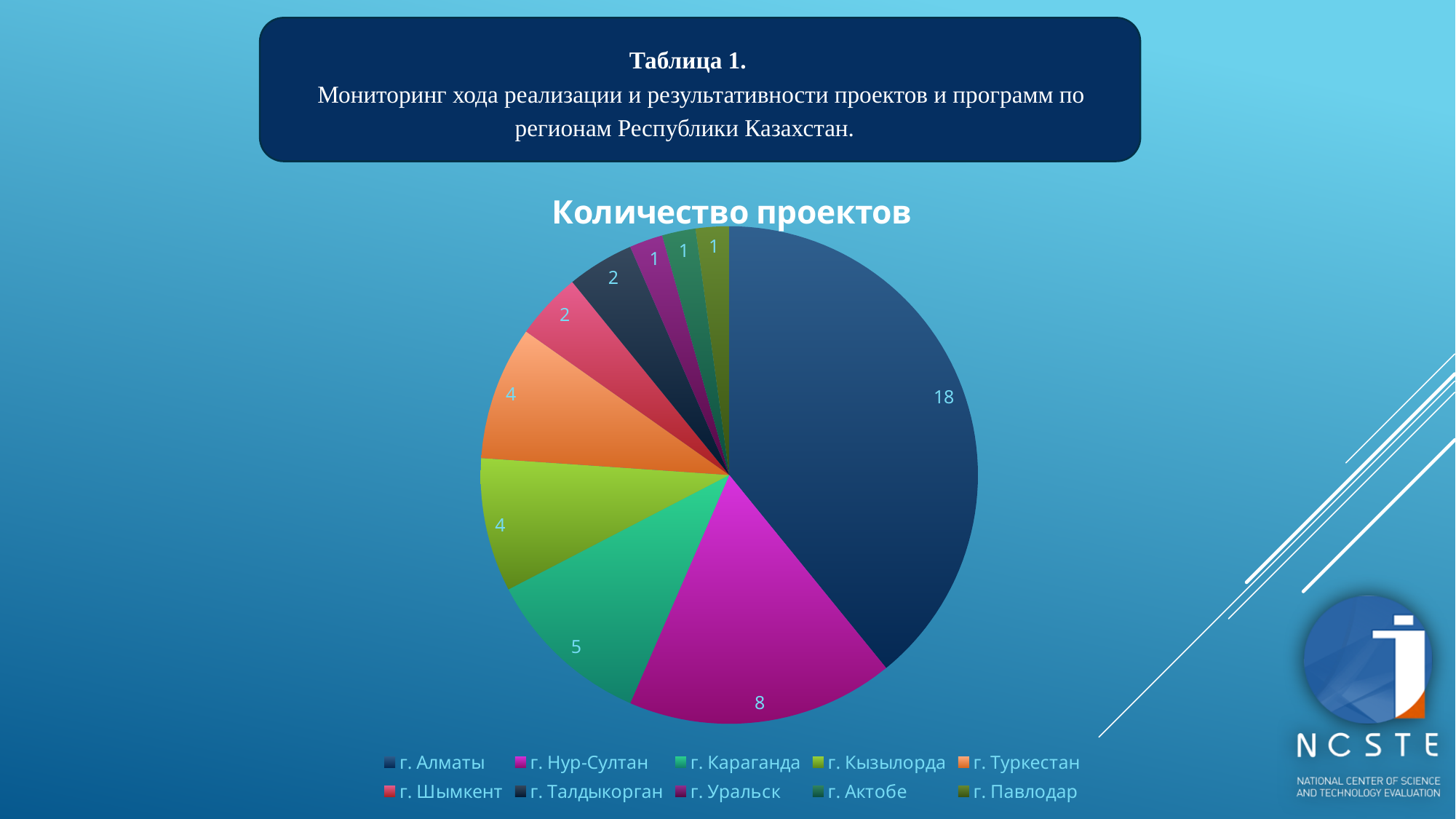
Which is larger, the value for г. Караганда or the value for г. Кызылорда? г. Караганда What is the difference between the values for г. Нур-Султан and г. Туркестан? 4 How many categories does the legend of the pie chart list? 10 How many projects does the slice for г. Алматы show? 18 What is the total of all the values shown in the pie chart? 46 What value is shown for г. Шымкент? 2 What is the value for г. Нур-Султан in the pie chart? 8 What is the value for г. Караганда? 5 Which city has the largest slice in the pie chart? г. Алматы What is the difference between the values for г. Алматы and г. Нур-Султан? 10 What is the title of the pie chart? Количество проектов What type of chart is shown on the slide? pie chart